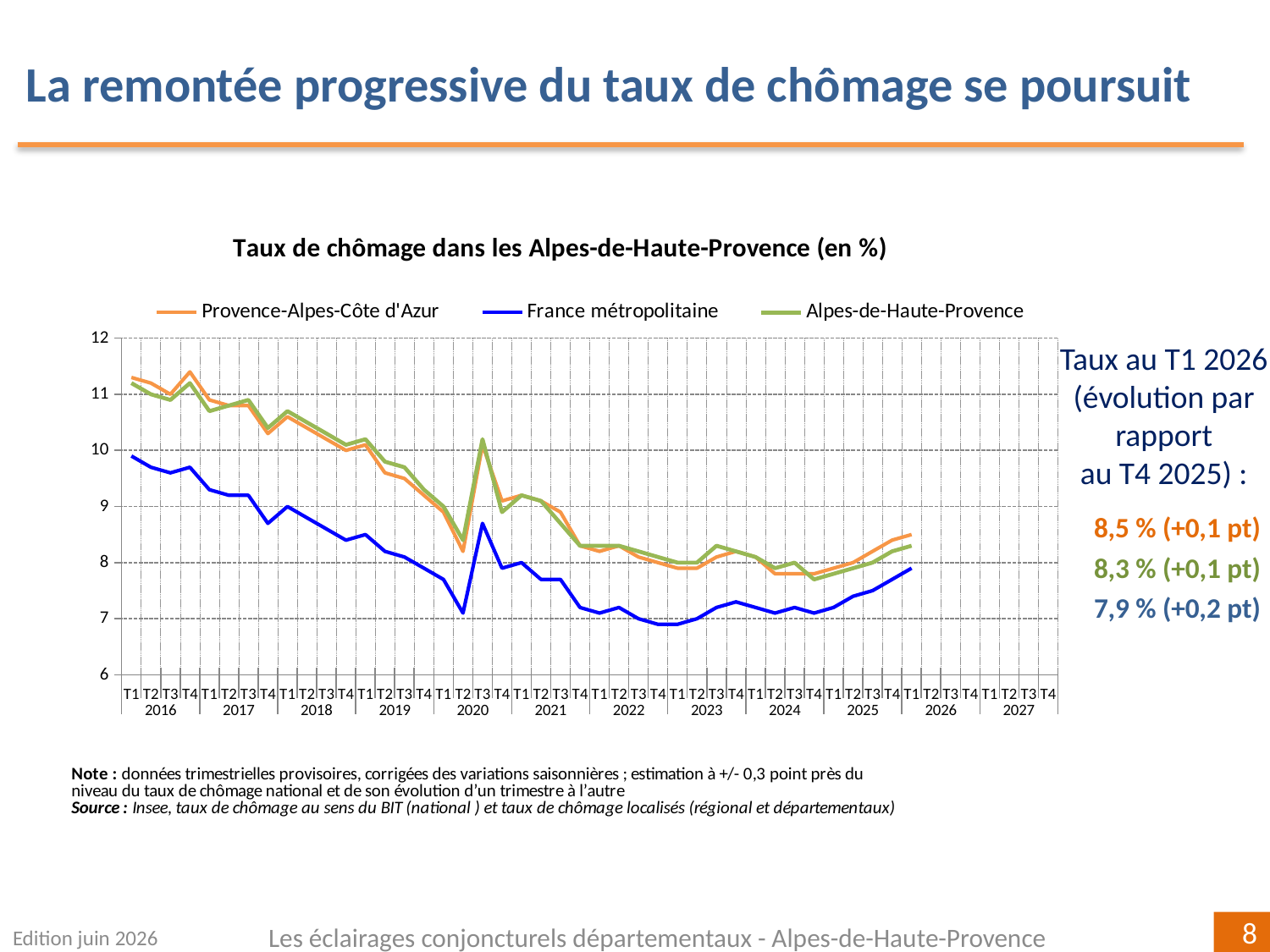
At T1 2026, which is higher: the rate for Provence-Alpes-Côte d'Azur or for France métropolitaine? Provence-Alpes-Côte d'Azur What is the unemployment rate for France métropolitaine at T1 2026? 7,9 % What is the unemployment rate for Alpes-de-Haute-Provence at T1 2026? 8,3 % By how much did the France métropolitaine rate change between T4 2025 and T1 2026? +0,2 pt Is the value for Alpes-de-Haute-Provence at T4 2022 greater or less than 9? less What is the unemployment rate for Provence-Alpes-Côte d'Azur at T1 2026? 8,5 % Is the value for France métropolitaine at T1 2016 greater or less than 9? greater What is the title of the chart? Taux de chômage dans les Alpes-de-Haute-Provence (en %) Which series has the lowest value at T1 2026? France métropolitaine What kind of chart is shown on the slide? line chart What is the difference between the Provence-Alpes-Côte d'Azur rate and the France métropolitaine rate at T1 2026? 0,6 pt How many series does the legend of the chart list? 3